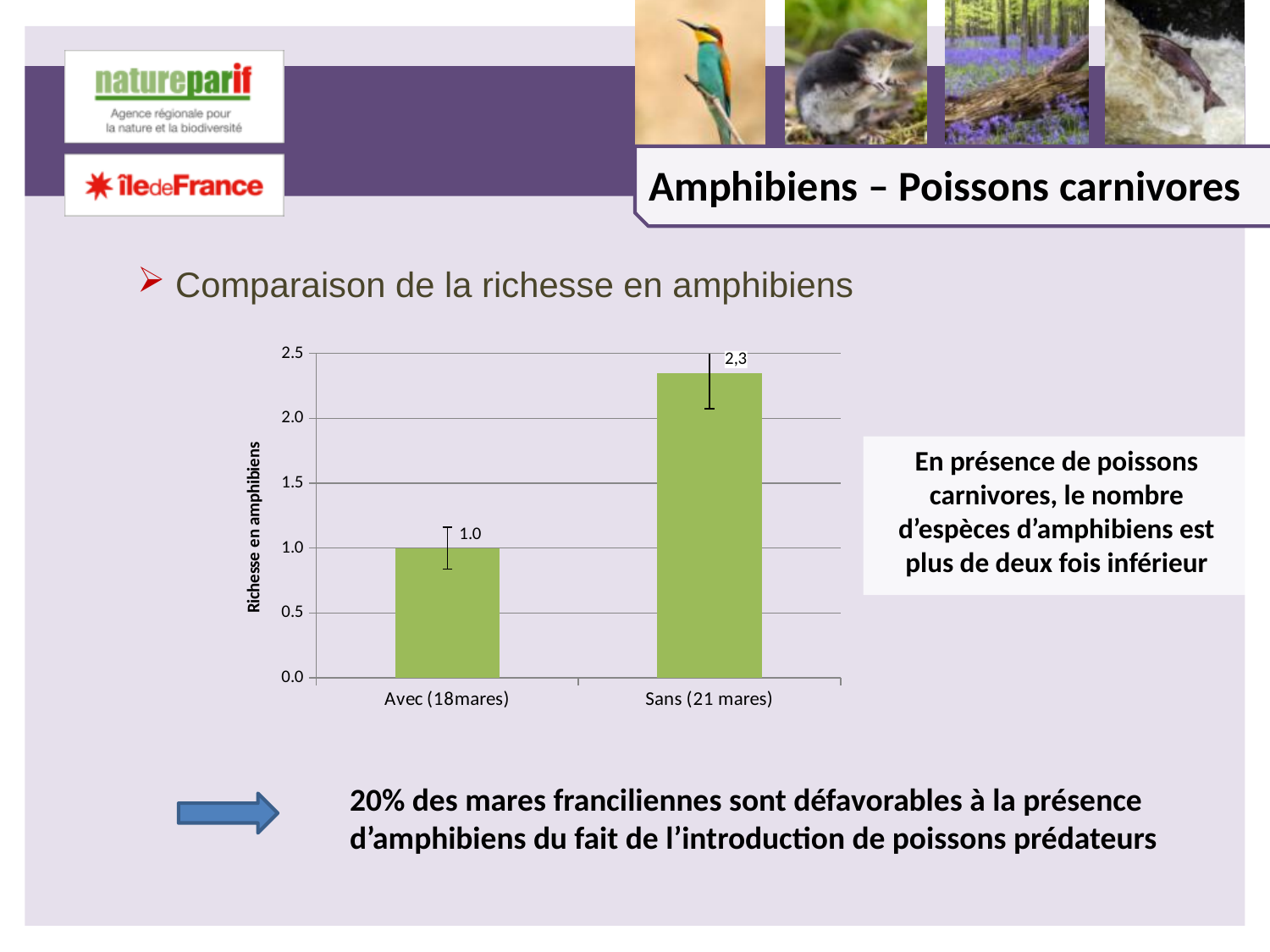
How many categories are shown on the x axis? 2 Is the value for Sans (21 mares) greater or less than 2.0? greater Is the value for Avec (18mares) greater or less than 1.5? less What is the label of the vertical axis? Richesse en amphibiens Which category has the highest value? Sans (21 mares) What is the value for Sans (21 mares)? 2,3 What is the difference between the value for Sans (21 mares) and the value for Avec (18mares)? 1.3 What colour are the bars in the chart? green What kind of chart is shown on the slide? bar chart What is the value for Avec (18mares)? 1.0 Which category has the lowest value? Avec (18mares) Which is larger, the value for Avec (18mares) or the value for Sans (21 mares)? Sans (21 mares)